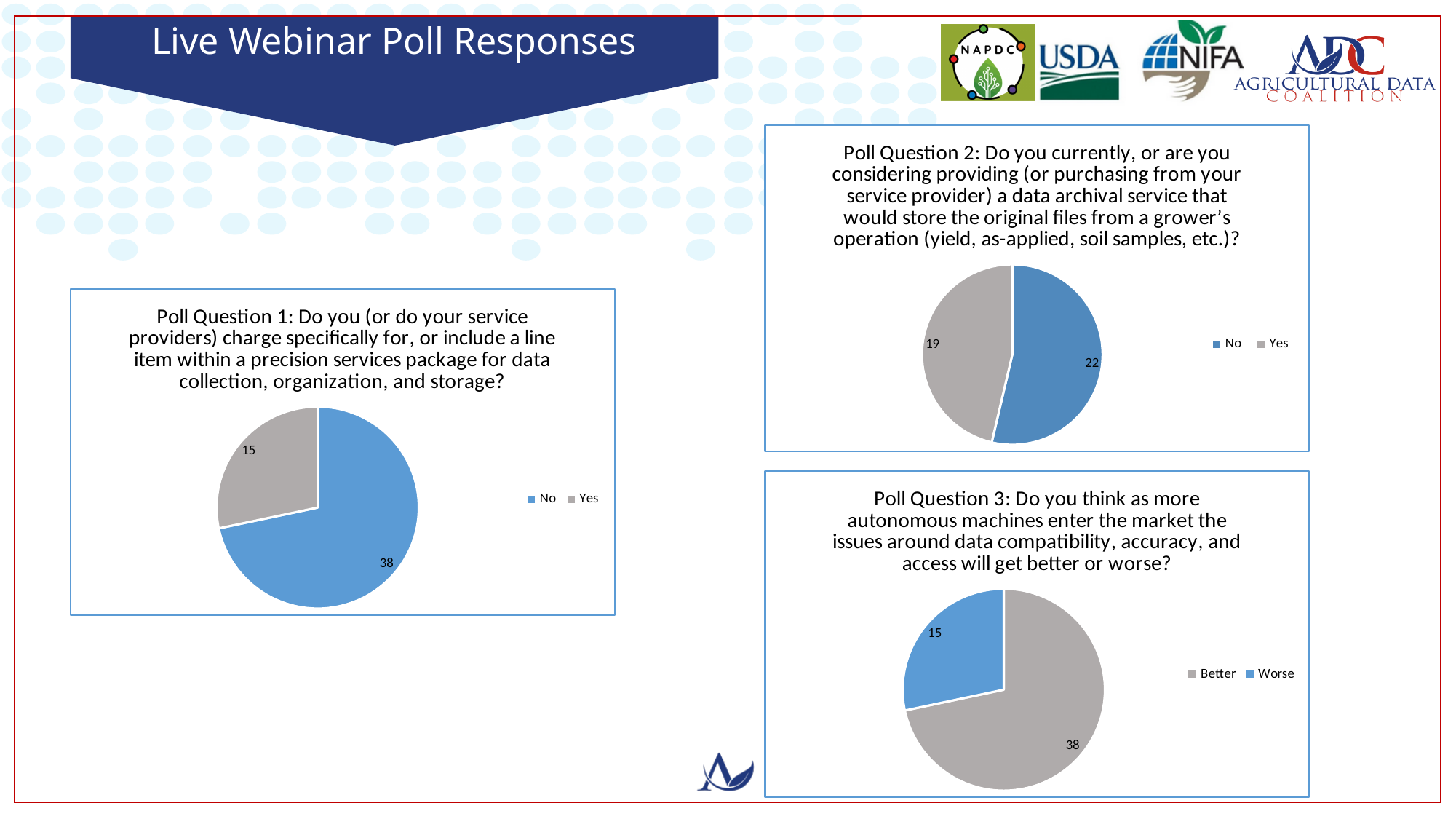
In the Poll Question 1 chart, how many respondents answered Yes? 15 In the Poll Question 2 chart, which response is the largest slice? No In the Poll Question 2 chart, what is the difference between the No and Yes responses? 3 What type of chart is used for Poll Question 3? Pie chart In the Poll Question 3 chart, how many respondents answered Worse? 15 How many entries does the legend of the Poll Question 3 chart list? 2 In the Poll Question 1 chart, how many respondents answered No? 38 In the Poll Question 1 chart, what is the difference between the No and Yes responses? 23 In the Poll Question 3 chart, how many respondents answered Better? 38 In the Poll Question 2 chart, how many respondents answered Yes? 19 In the Poll Question 3 chart, which response received more votes, Better or Worse? Better In the Poll Question 2 chart, how many respondents answered No? 22